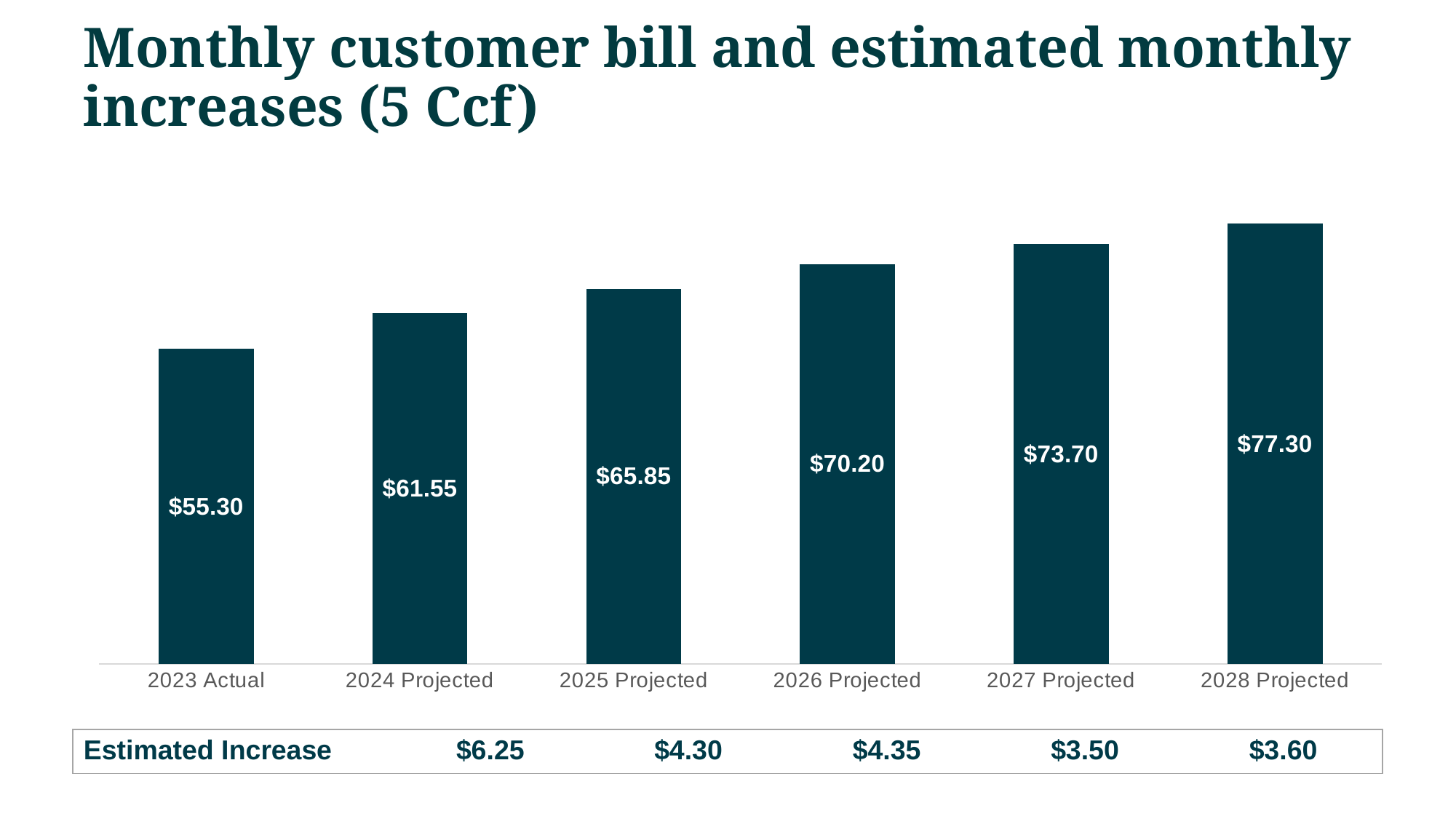
Which category has the lowest monthly customer bill? 2023 Actual How many categories are shown on the x axis? 6 What is the difference between the monthly bill for 2028 Projected and 2027 Projected? $3.60 What is the title of the chart? Monthly customer bill and estimated monthly increases (5 Ccf) Which category has the highest monthly customer bill? 2028 Projected Do the monthly bill values rise or fall from 2023 Actual to 2028 Projected? Rise Which is larger, the monthly bill for 2025 Projected or 2027 Projected? 2027 Projected What kind of chart is shown on the slide? Bar chart What is the monthly customer bill for 2026 Projected? $70.20 What is the difference between the monthly bill for 2024 Projected and 2023 Actual? $6.25 What is the monthly customer bill for 2028 Projected? $77.30 What is the monthly customer bill for 2023 Actual? $55.30